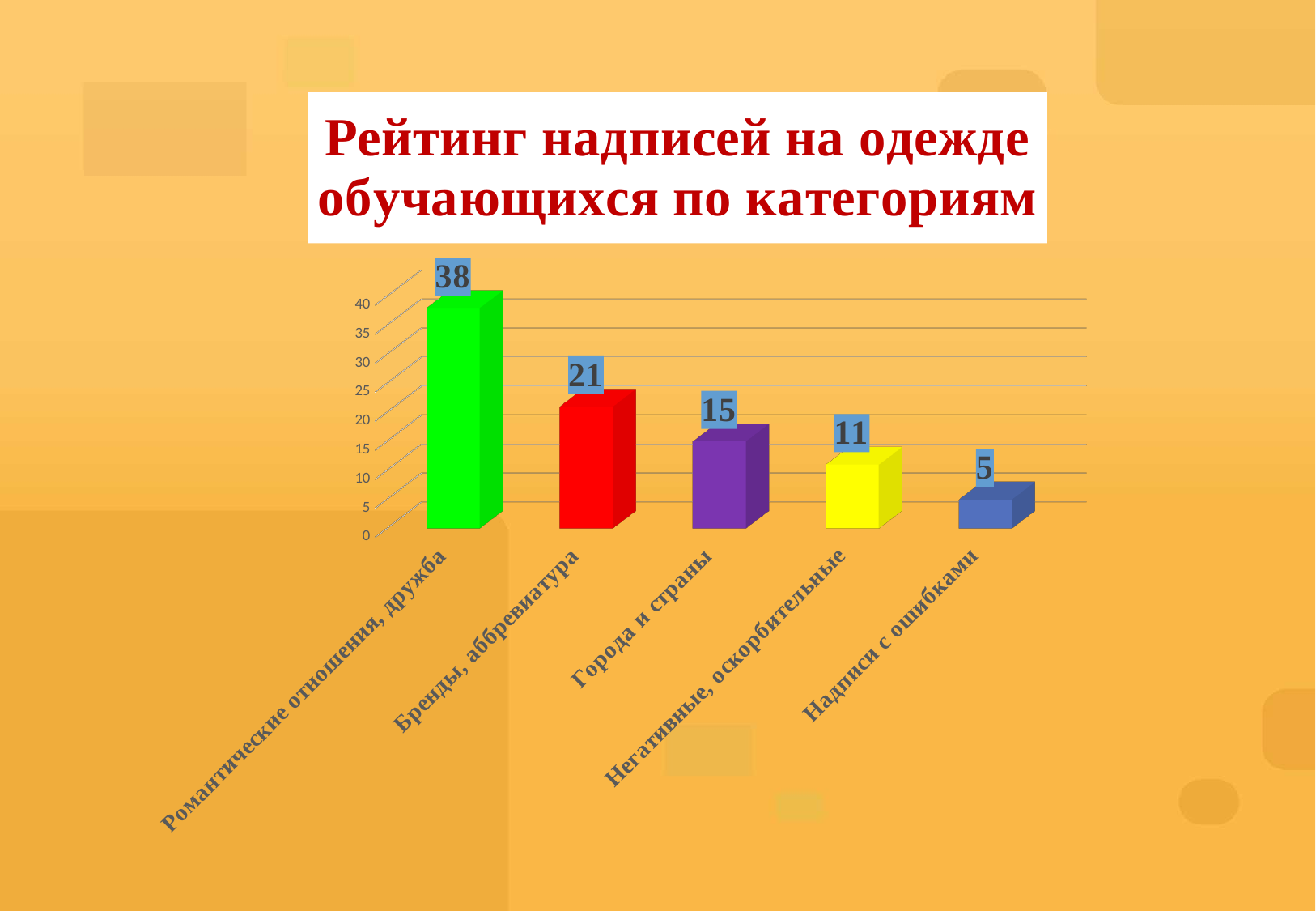
Which category has the highest value? Романтические отношения, дружба What is the value for "Негативные, оскорбительные"? 11 What is the title of the slide? Рейтинг надписей на одежде обучающихся по категориям Which is larger, the value for "Города и страны" or the value for "Негативные, оскорбительные"? Города и страны What is the value for "Романтические отношения, дружба"? 38 How many categories are shown in the chart? 5 What is the value for "Города и страны"? 15 What kind of chart is shown on the slide? Bar chart What is the value for "Бренды, аббревиатура"? 21 Which category has the lowest value? Надписи с ошибками What is the value for "Надписи с ошибками"? 5 What is the difference between the values for "Романтические отношения, дружба" and "Бренды, аббревиатура"? 17